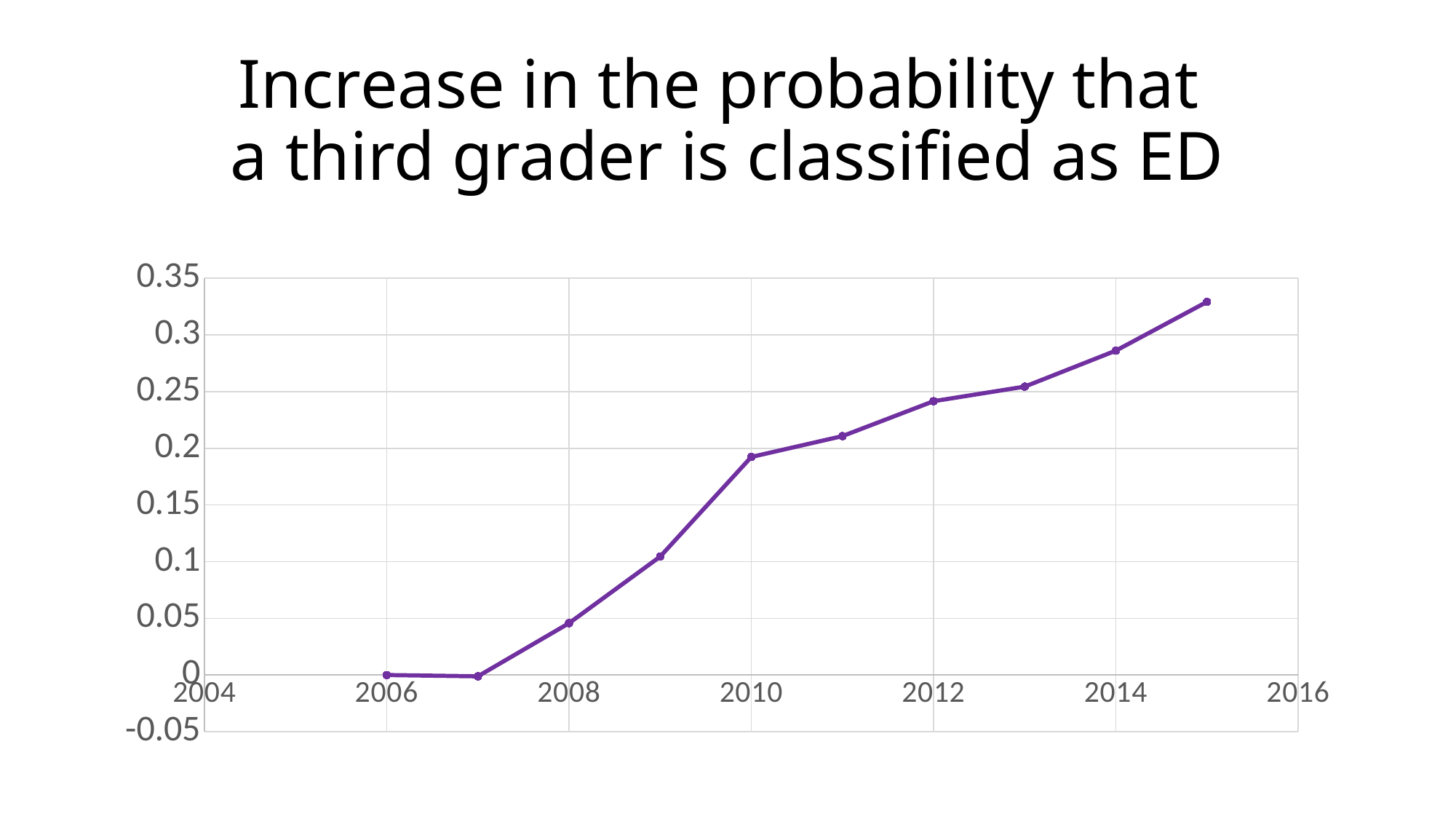
Which is larger, the value for 2012 or the value for 2014? 2014 Is the value for 2014 greater or less than 0.25? greater Which year has the highest value? 2015 Is the value for 2010 greater or less than 0.15? greater Is the value for 2015 greater or less than 0.3? greater What kind of chart is shown on the slide? line chart Do the values generally rise or fall from 2006 to 2015? rise Which is larger, the value for 2010 or the value for 2008? 2010 How many data points are plotted on the line? 10 What is the title of the slide? Increase in the probability that a third grader is classified as ED